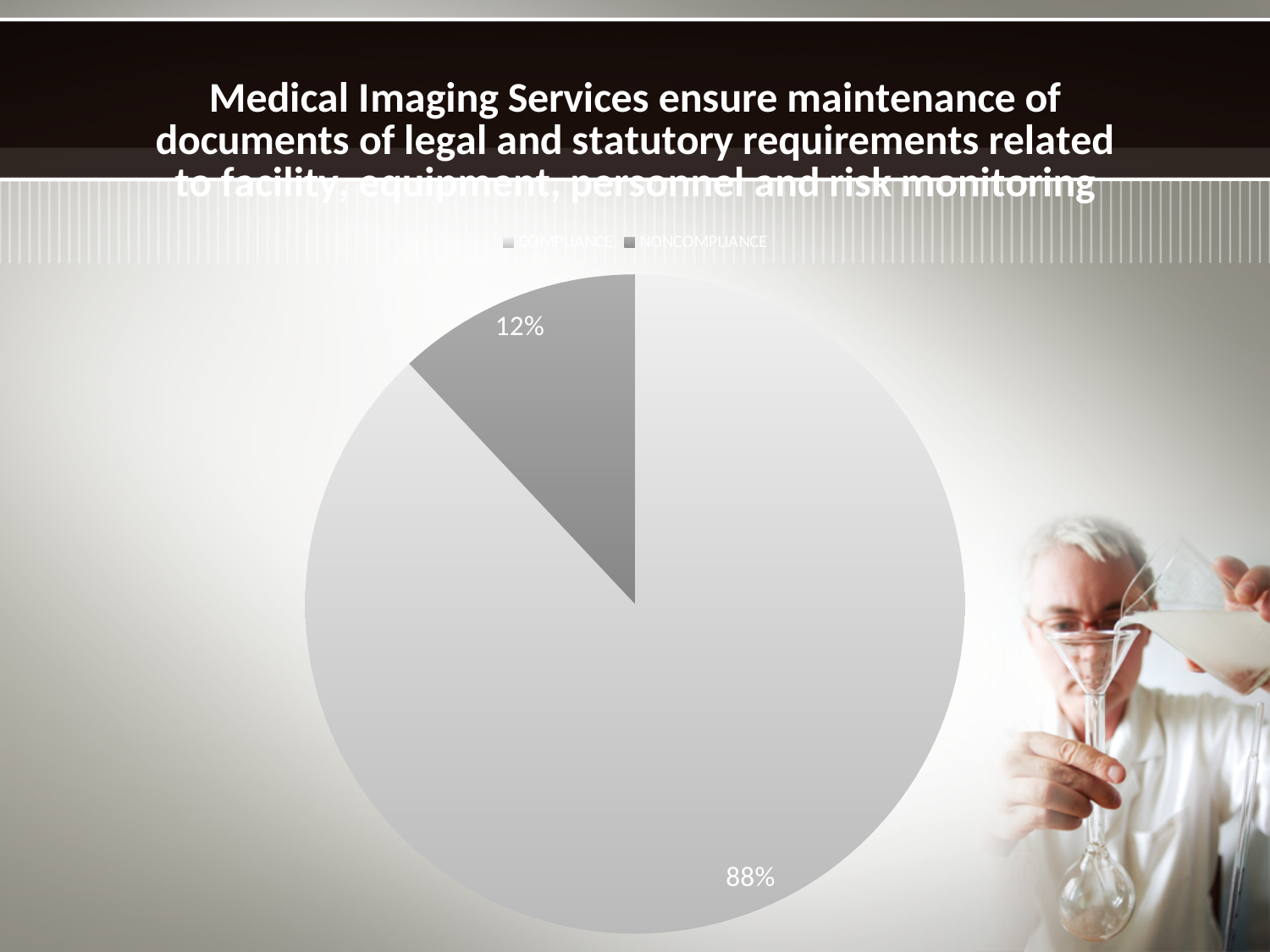
Which is larger, the COMPLIANCE slice or the NONCOMPLIANCE slice? COMPLIANCE What is the difference in percentage points between the COMPLIANCE and NONCOMPLIANCE slices? 76 What are the two legend entries of the chart? COMPLIANCE and NONCOMPLIANCE Is the NONCOMPLIANCE slice greater or less than 50% of the pie? less Which slice is the smallest? NONCOMPLIANCE Which slice is the largest? COMPLIANCE What share of the pie does NONCOMPLIANCE represent? 12% How many entries does the legend list? 2 What share of the pie does COMPLIANCE represent? 88% How many slices does the pie chart have? 2 What kind of chart is shown on the slide? pie chart